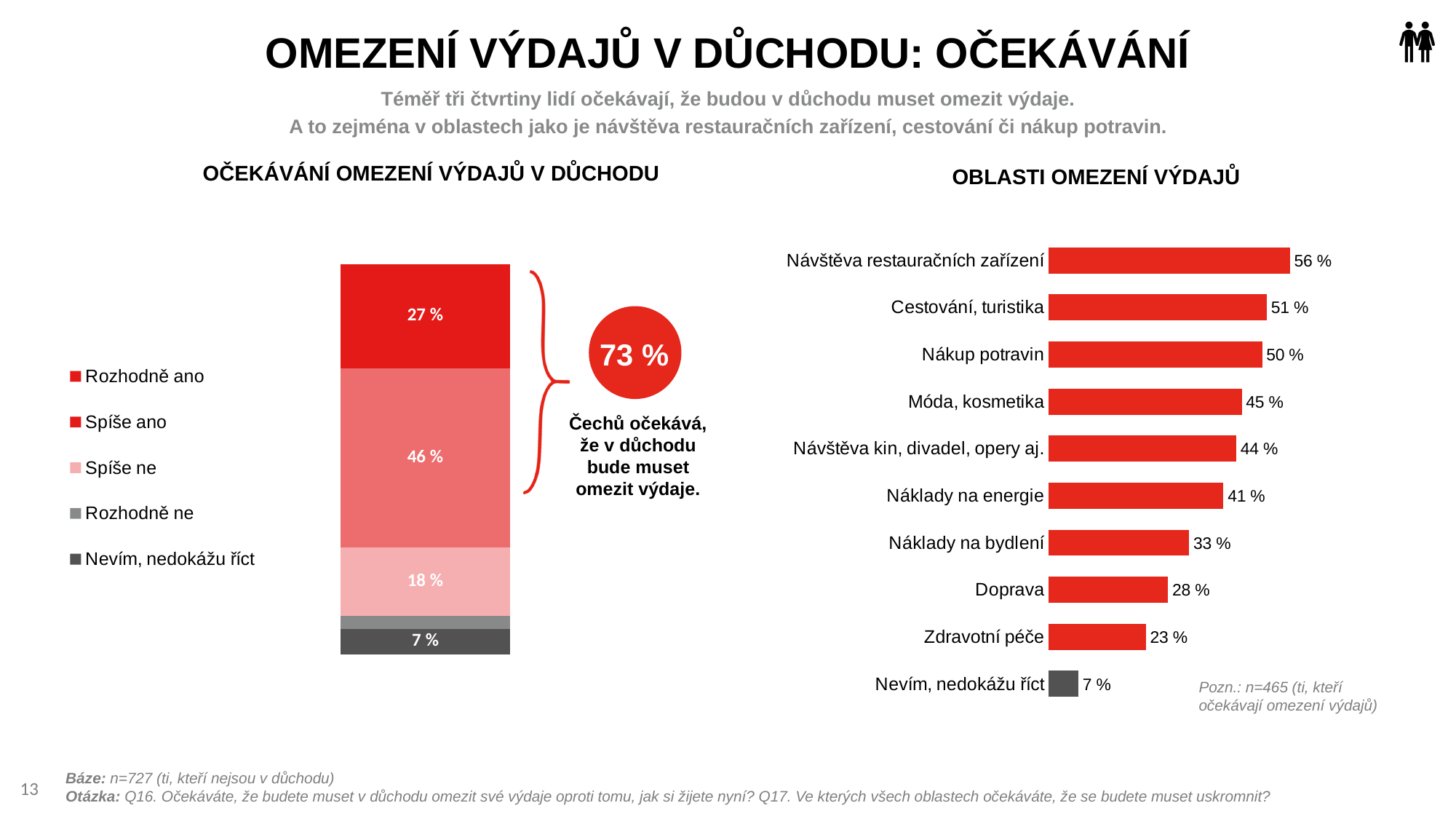
In the chart 'OČEKÁVÁNÍ OMEZENÍ VÝDAJŮ V DŮCHODU', what is the difference between the values for 'Spíše ano' and 'Rozhodně ano'? 19 % In the chart 'OBLASTI OMEZENÍ VÝDAJŮ', which category has the lowest value? Nevím, nedokážu říct How many entries does the legend of the chart 'OČEKÁVÁNÍ OMEZENÍ VÝDAJŮ V DŮCHODU' list? 5 In the chart 'OBLASTI OMEZENÍ VÝDAJŮ', what is the value for 'Náklady na bydlení'? 33 % How many categories are shown in the chart 'OBLASTI OMEZENÍ VÝDAJŮ'? 10 In the chart 'OBLASTI OMEZENÍ VÝDAJŮ', what is the difference between the values for 'Nákup potravin' and 'Doprava'? 22 % In the chart 'OBLASTI OMEZENÍ VÝDAJŮ', what is the value for 'Cestování, turistika'? 51 % In the chart 'OČEKÁVÁNÍ OMEZENÍ VÝDAJŮ V DŮCHODU', what is the value for 'Spíše ne'? 18 % In the chart 'OBLASTI OMEZENÍ VÝDAJŮ', which is larger: 'Náklady na energie' or 'Zdravotní péče'? Náklady na energie In the chart 'OBLASTI OMEZENÍ VÝDAJŮ', which category has the highest value? Návštěva restauračních zařízení What kind of chart is 'OBLASTI OMEZENÍ VÝDAJŮ'? Bar chart In the chart 'OČEKÁVÁNÍ OMEZENÍ VÝDAJŮ V DŮCHODU', what is the value for 'Spíše ano'? 46 %